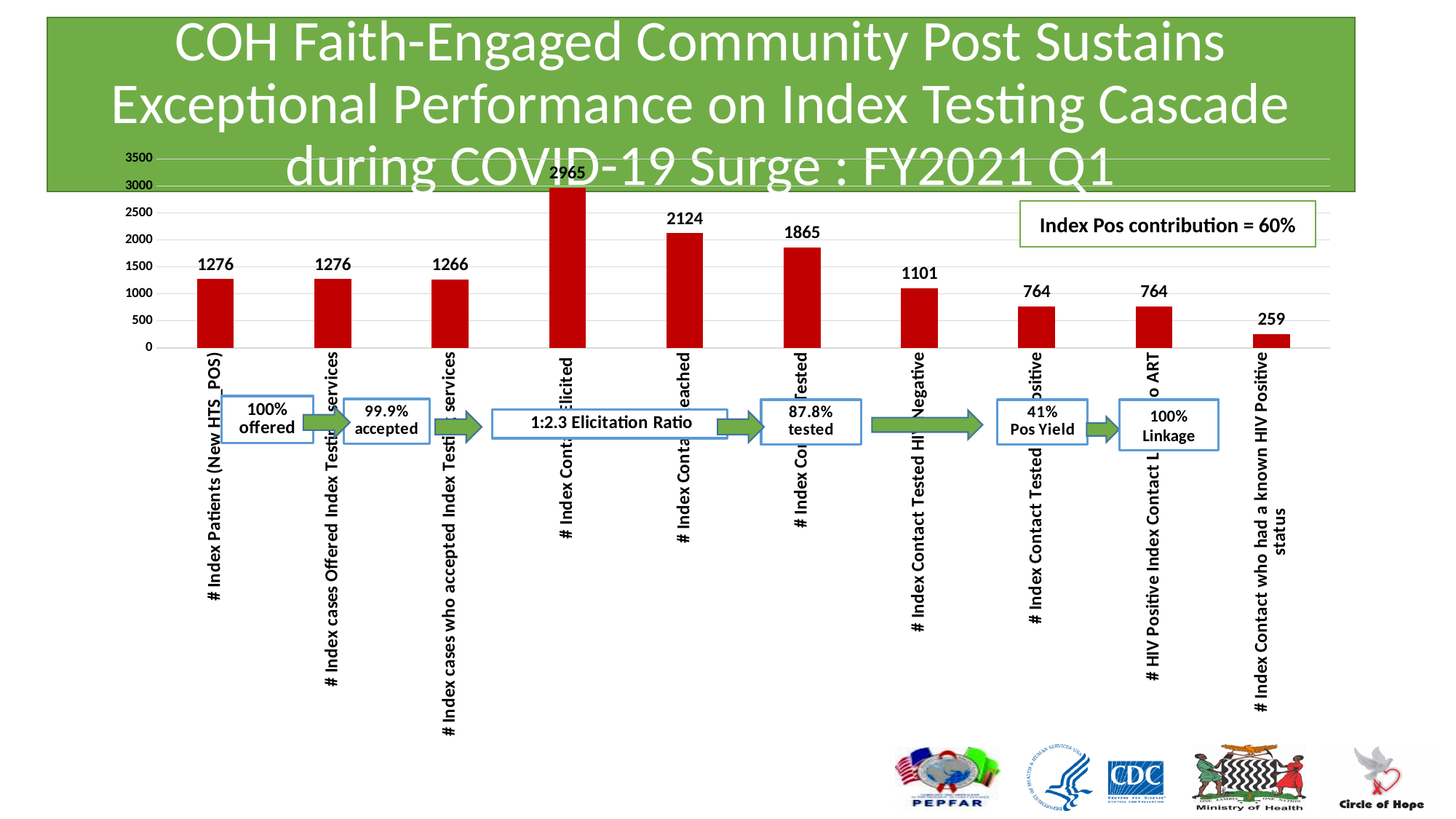
What is the value for "# Index Patients (New HTS_POS)"? 1276 What is the difference between the value for "# Index Patients (New HTS_POS)" and the value for "# Index Contact who had a known HIV Positive status"? 1017 Which is larger: the value of the first bar (# Index Patients (New HTS_POS)) or the value of the third bar? # Index Patients (New HTS_POS) How many bars are plotted in the chart? 10 Is the value of the tallest bar greater or less than 2500? greater What is the highest value shown on the vertical axis? 3500 What Index Pos contribution percentage is stated in the box at the top right of the chart? 60% What is the value for "# Index Contact who had a known HIV Positive status"? 259 What is the difference between the tallest bar (2965) and the bar labelled 2124 immediately to its right? 841 What type of chart is shown on the slide? bar chart What is the value of the tallest bar in the chart? 2965 Which category has the lowest value in the chart? # Index Contact who had a known HIV Positive status